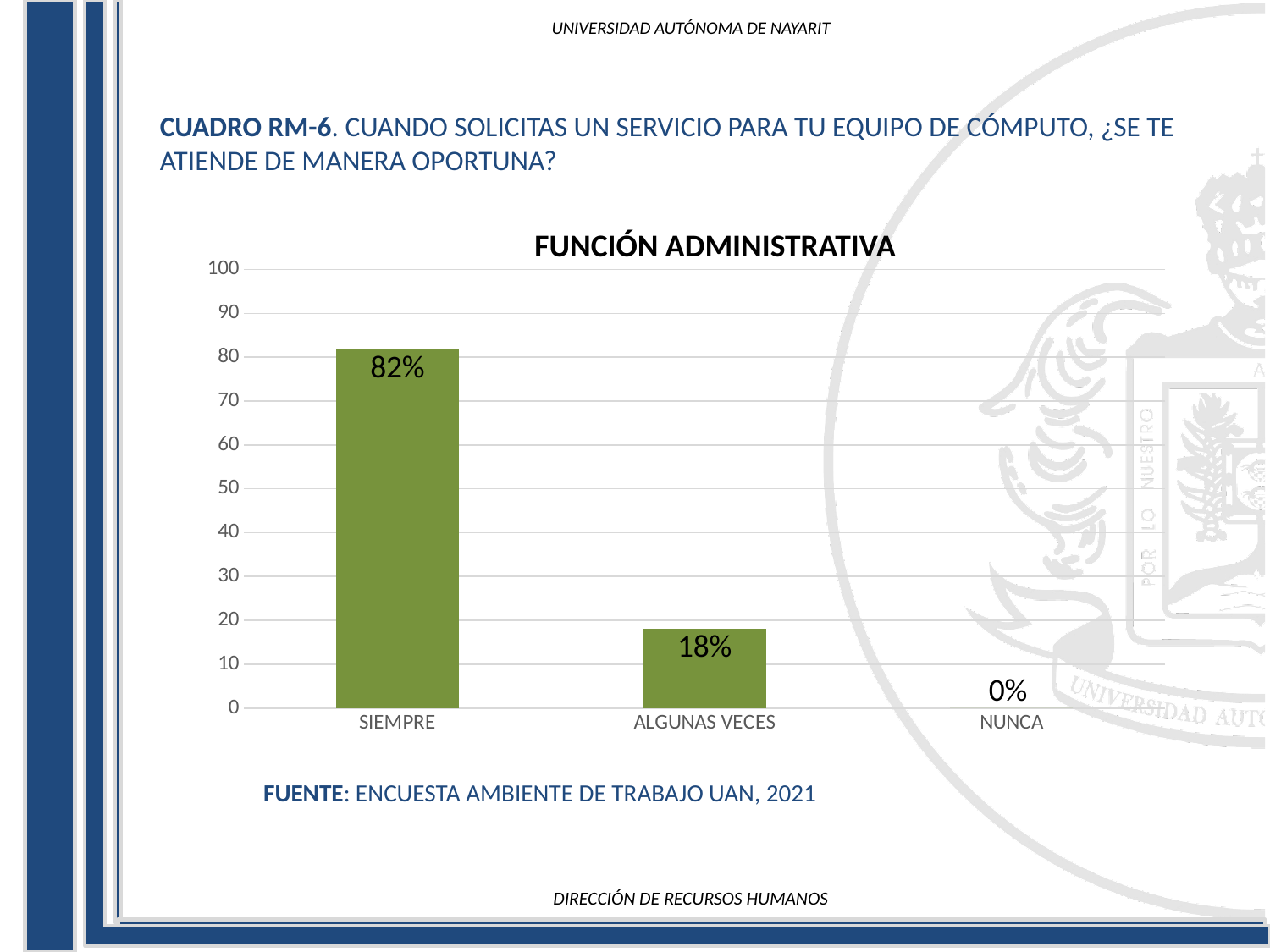
Do the values rise or fall from left to right along the x axis? fall What is the value for ALGUNAS VECES? 18% Which is larger, the value for ALGUNAS VECES or the value for NUNCA? ALGUNAS VECES Which category has the highest value? SIEMPRE What is the title of the chart? FUNCIÓN ADMINISTRATIVA Which category has the lowest value? NUNCA Is the value for SIEMPRE greater or less than 70? greater What is the difference between the values for SIEMPRE and ALGUNAS VECES? 64% What is the value for NUNCA? 0% What kind of chart is shown? bar chart What is the value for SIEMPRE? 82% How many categories are shown on the x axis? 3